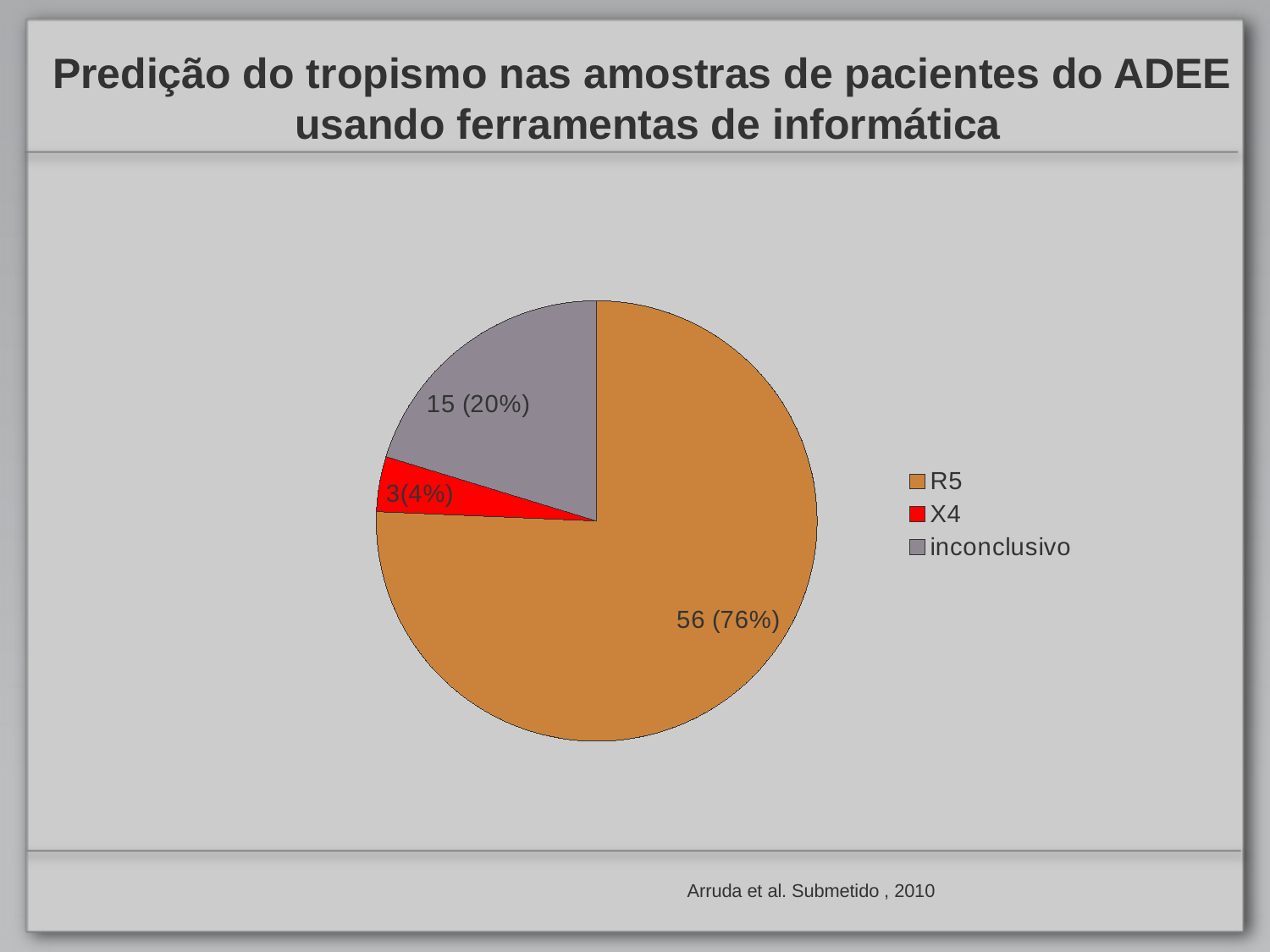
What is the data label for the R5 slice? 56 (76%) What colour is the X4 slice? red Which category has the smallest slice? X4 What is the data label for the inconclusivo slice? 15 (20%) What kind of chart is shown on the slide? pie chart Which is larger, the X4 slice or the inconclusivo slice? inconclusivo Which category has the largest slice? R5 What is the difference in count between the R5 and inconclusivo slices? 41 What share of the pie does the inconclusivo slice represent? 20% What is the data label for the X4 slice? 3(4%) How many entries does the legend list? 3 How many slices does the pie chart have? 3